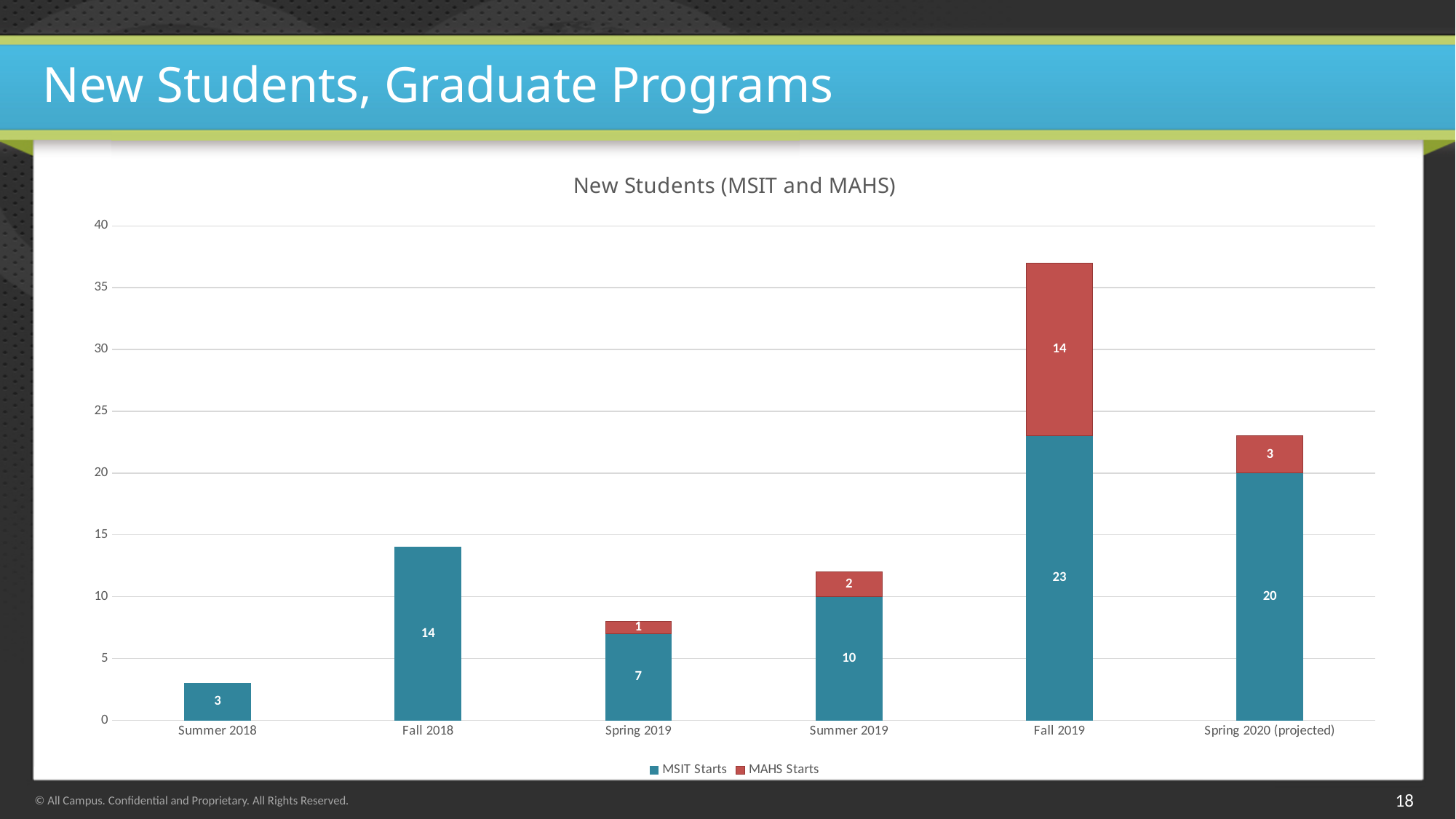
What is the total of the stacked bar for Fall 2019? 37 Which period has the lowest MSIT Starts value? Summer 2018 Which is larger, the MAHS Starts value for Fall 2019 or for Summer 2019? Fall 2019 How many periods are shown on the x axis? 6 What is the MAHS Starts value for Spring 2020 (projected)? 3 What is the MSIT Starts value for Fall 2019? 23 What is the difference between the MSIT Starts values for Fall 2019 and Spring 2020 (projected)? 3 What kind of chart is shown on the slide? Stacked bar chart What is the total of the stacked bar for Summer 2019? 12 Which period has the highest MSIT Starts value? Fall 2019 How many series does the legend list? 2 What is the MSIT Starts value for Summer 2018? 3